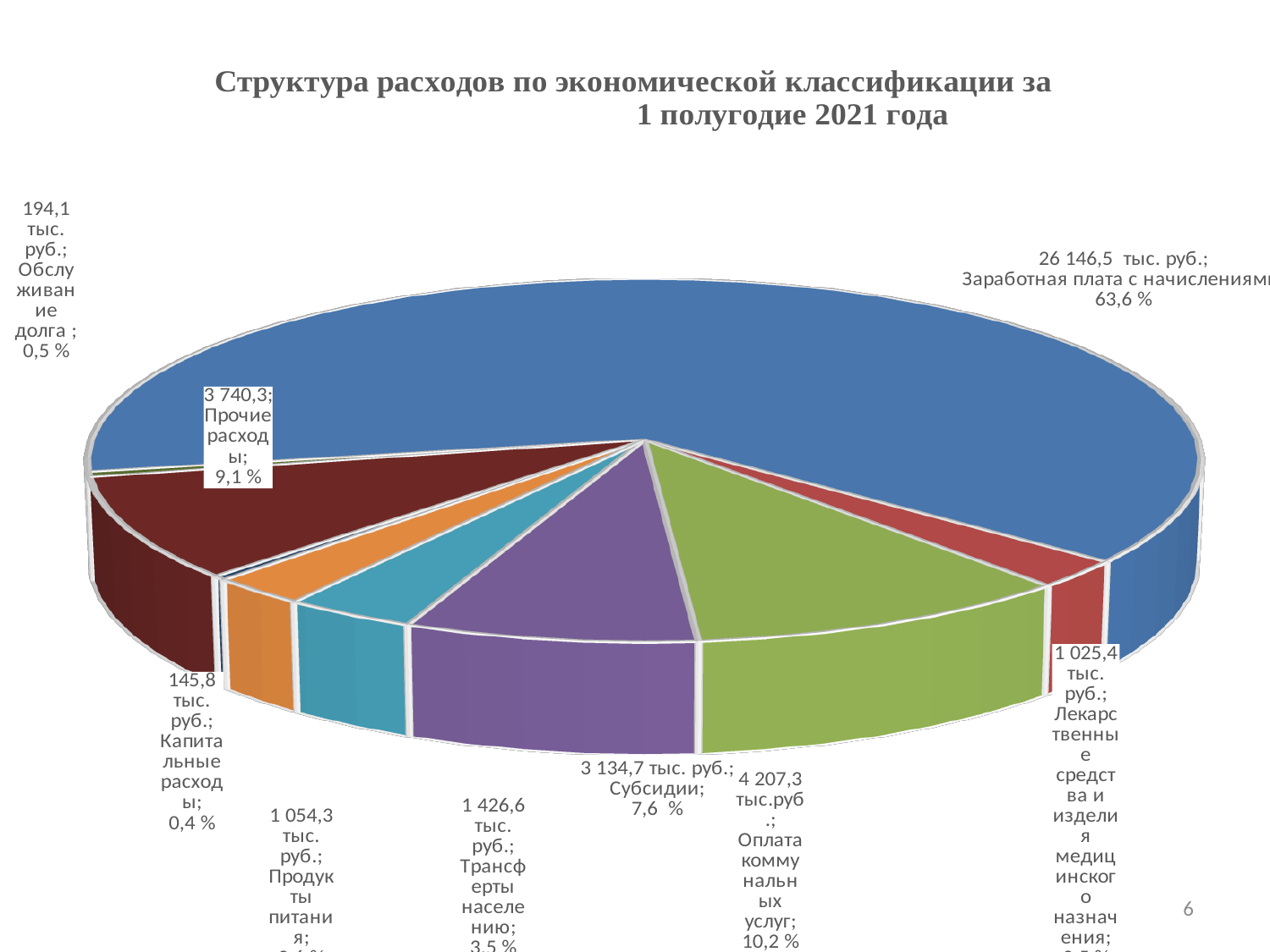
What share of the pie does Прочие расходы take? 9,1 % Which is larger, Оплата коммунальных услуг or Субсидии? Оплата коммунальных услуг What share of the pie does Заработная плата с начислениями take? 63,6 % What is the value for Капитальные расходы? 145,8 тыс. руб. What kind of chart is shown on the slide? pie chart Which category has the smallest slice of the pie? Капитальные расходы What share of the pie does Субсидии take? 7,6 % What is the title of the chart? Структура расходов по экономической классификации за 1 полугодие 2021 года Which category has the largest slice of the pie? Заработная плата с начислениями How many categories are shown in the pie chart? 9 What is the value for Оплата коммунальных услуг? 4 207,3 тыс.руб. What is the value for Заработная плата с начислениями? 26 146,5 тыс. руб.